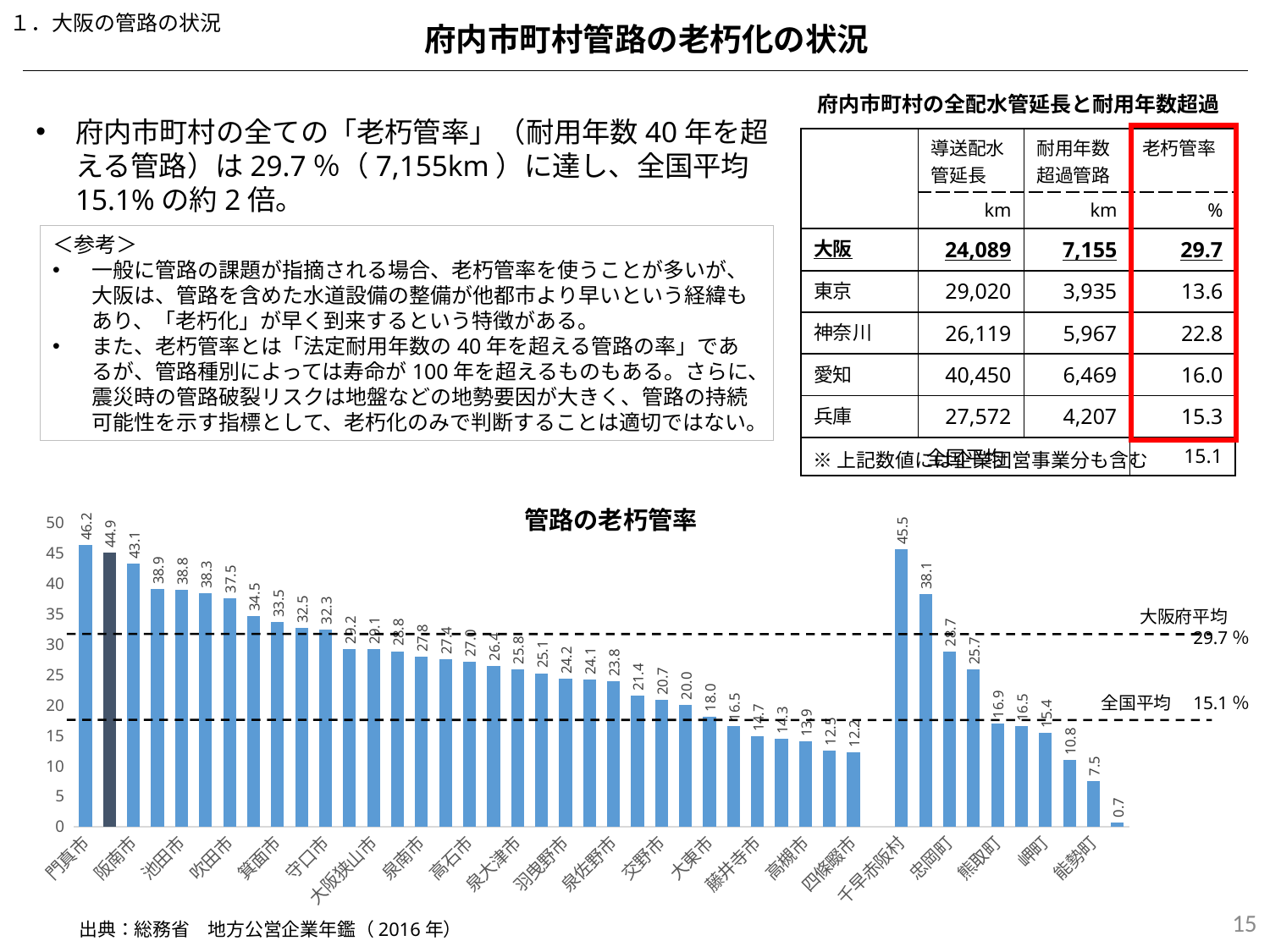
In the 管路の老朽管率 chart, what is the value for 千早赤阪村? 45.5 In the 管路の老朽管率 chart, what value is given for the 大阪府平均 dashed line? 29.7% What is the highest value shown by any bar in the 管路の老朽管率 chart? 46.2 In the 管路の老朽管率 chart, what is the difference between the 大阪府平均 (29.7%) and the 全国平均 (15.1%)? 14.6 What is the lowest value shown by any bar in the 管路の老朽管率 chart? 0.7 In the 管路の老朽管率 chart, what is the value for 門真市? 46.2 Which municipality has the highest bar in the 管路の老朽管率 chart? 門真市 In the 管路の老朽管率 chart, what value is given for the 全国平均 dashed line? 15.1% In the 管路の老朽管率 chart, which has the larger value, 門真市 or 千早赤阪村? 門真市 What is the title of the bar chart? 管路の老朽管率 What kind of chart is shown at the bottom of the slide? bar chart What is the maximum value shown on the y-axis of the 管路の老朽管率 chart? 50